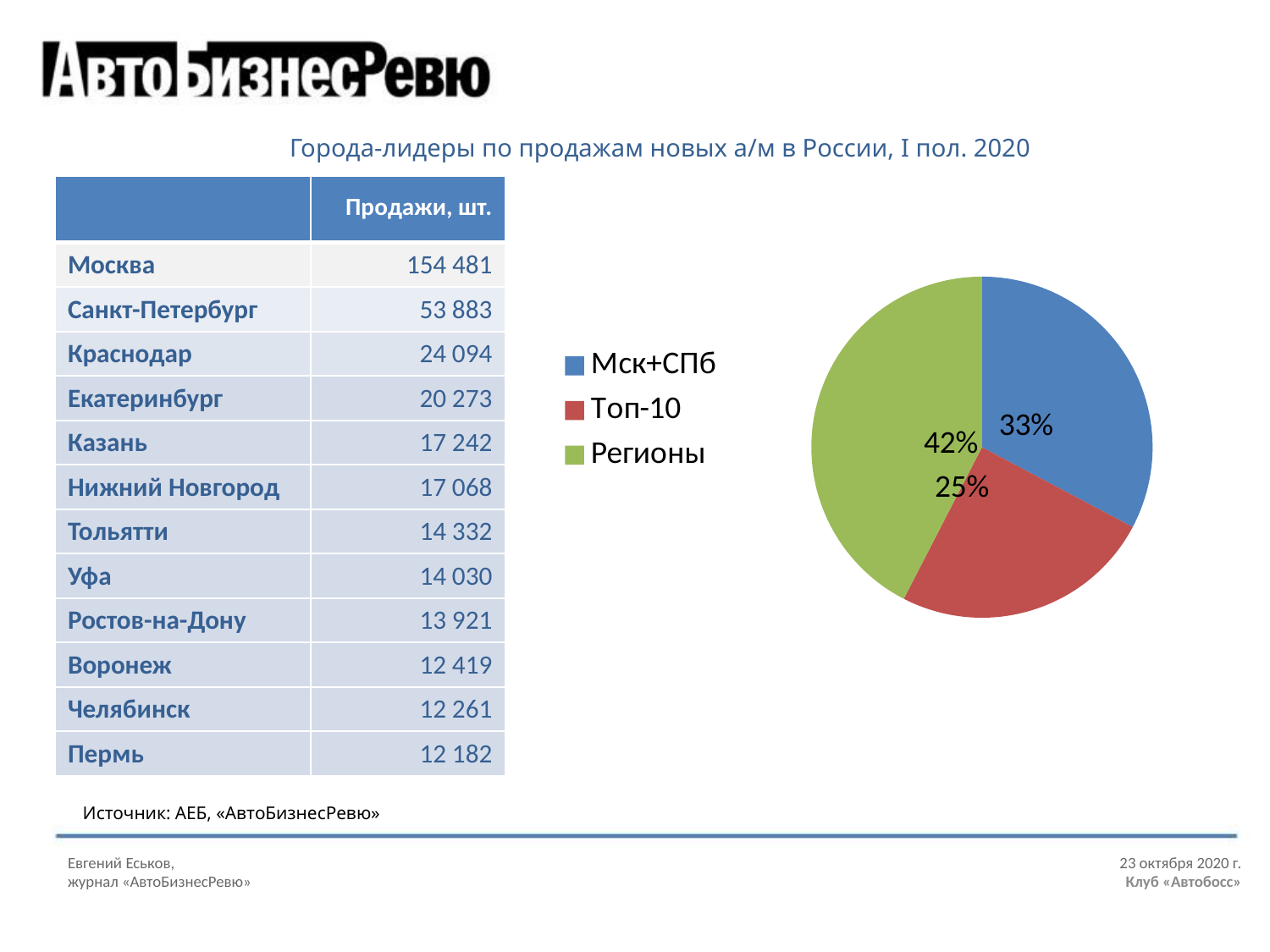
Which slice of the pie chart is the largest? Регионы In the pie chart, what share does Мск+СПб have? 33% In the pie chart, what share does Топ-10 have? 25% In the pie chart, what share does Регионы have? 42% How many entries does the legend of the pie chart list? 3 What kind of chart is shown on the slide? pie chart What colour is the Регионы slice in the pie chart? green Which is larger in the pie chart, Мск+СПб or Топ-10? Мск+СПб What is the difference in percentage points between the Регионы slice and the Мск+СПб slice? 9 How many slices does the pie chart have? 3 Which slice of the pie chart is the smallest? Топ-10 What colour is the Топ-10 slice in the pie chart? red